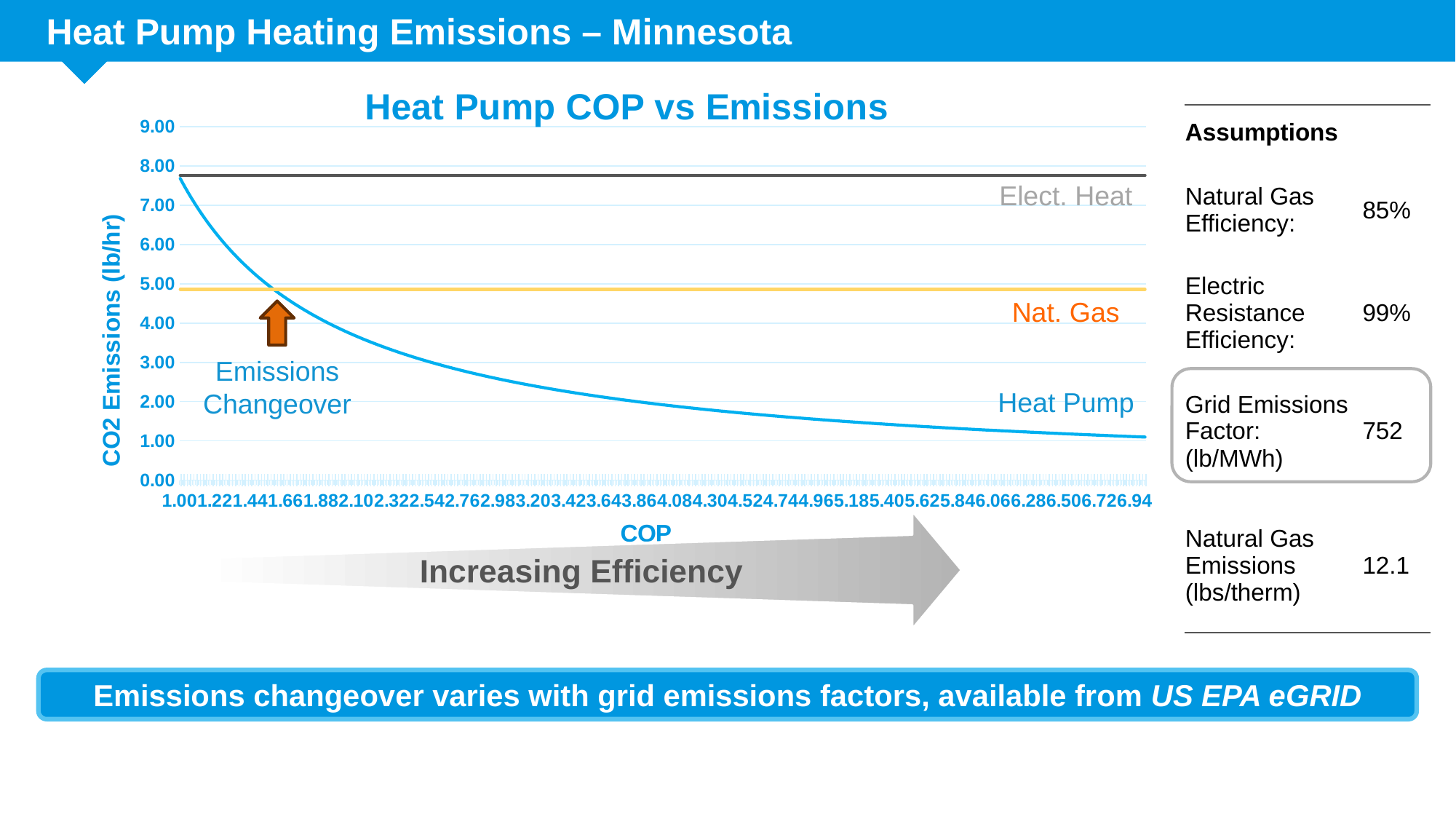
Which series has the lowest CO2 emissions at the highest COP shown (6.94)? Heat Pump What kind of chart is shown on the slide? line chart Is the value for Heat Pump at a COP of 6.94 greater or less than 2.00? less Does the Heat Pump line rise or fall as COP increases? fall Is the value for Elect. Heat greater or less than 7.00? greater Which is larger, the emissions for Elect. Heat or for Nat. Gas? Elect. Heat What is the label of the vertical axis of the chart? CO2 Emissions (lb/hr) What is the title of the chart? Heat Pump COP vs Emissions At a COP of 6.94, which is larger, the emissions for Heat Pump or for Nat. Gas? Nat. Gas Is the value for Nat. Gas greater or less than 4.00? greater How many series are plotted on the chart? 3 Which series has the highest CO2 emissions on the chart? Elect. Heat